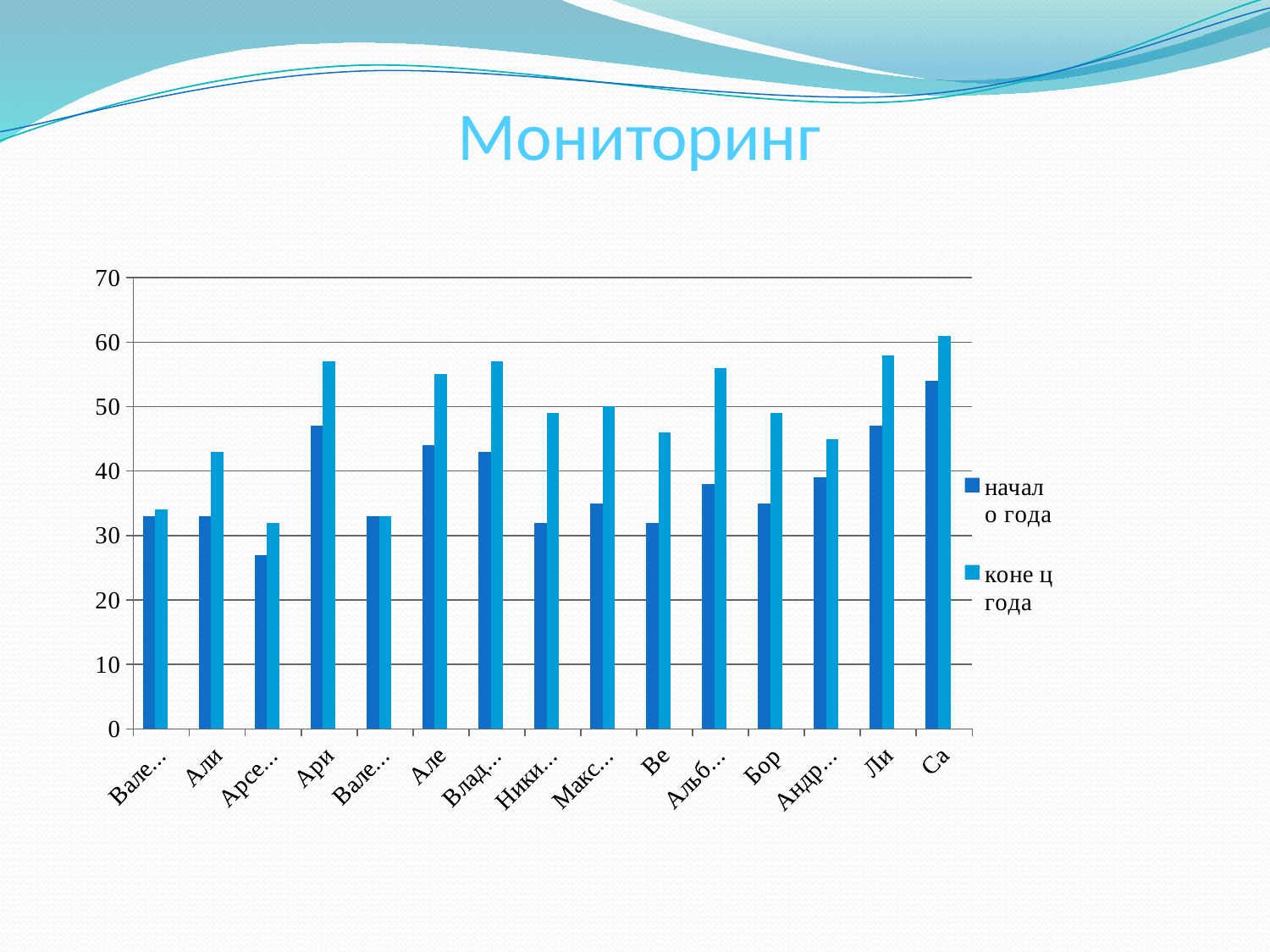
Which is larger for конец года: Ари or Али? Ари Which category has the highest value for конец года? Са What kind of chart is shown on the slide? bar chart Is the value for Са in the начало года series greater or less than 50? greater Is the value for Али in the конец года series greater or less than 40? greater Is the value for Бор in the начало года series greater or less than 40? less What is the title of the chart? Мониторинг Which is larger for начало года: Са or Ли? Са How many series does the legend list? 2 What are the two series named in the legend? начало года, конец года How many categories are shown along the x axis? 15